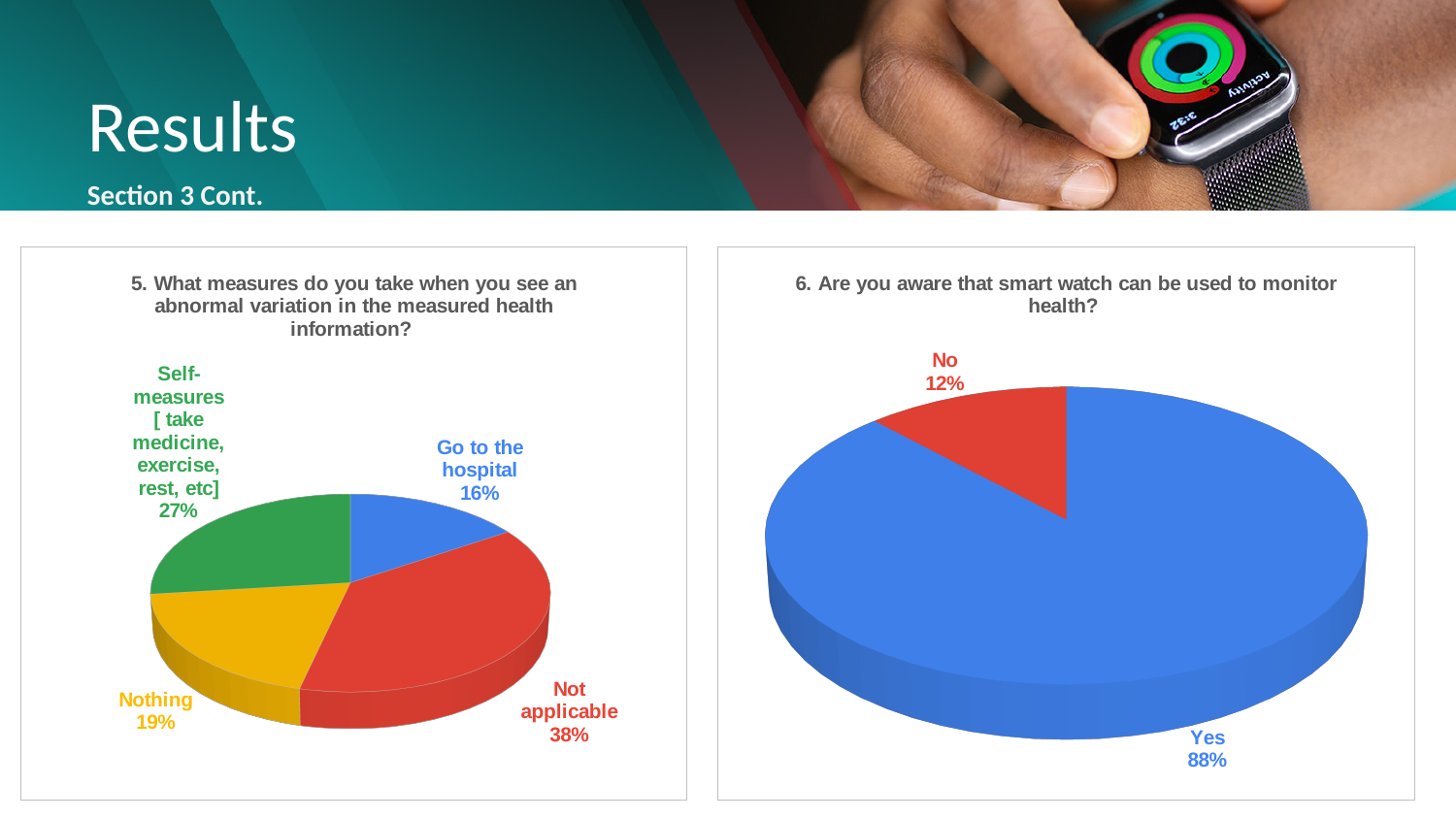
How many categories are shown in the left chart (question 5)? 4 In the left chart (question 5), which is larger: the share for 'Nothing' or the share for 'Go to the hospital'? Nothing In the left chart (question 5), which category has the largest share? Not applicable In the right chart (question 6), what is the difference in percentage points between 'Yes' and 'No'? 76 In the left chart (question 5), which category has the smallest share? Go to the hospital In the left chart (question 5), what share of respondents answered 'Go to the hospital'? 16% In the right chart (question 6, awareness that a smart watch can monitor health), what share of respondents answered 'Yes'? 88% In the left chart (question 5, measures taken on abnormal variation), what share of respondents answered 'Not applicable'? 38% In the right chart (question 6), what share of respondents answered 'No'? 12% In the left chart (question 5), what is the difference in percentage points between 'Not applicable' and 'Self-measures'? 11 What type of chart is used for question 6 on the right side of the slide? Pie chart In the left chart (question 5), what share of respondents answered 'Nothing'? 19%